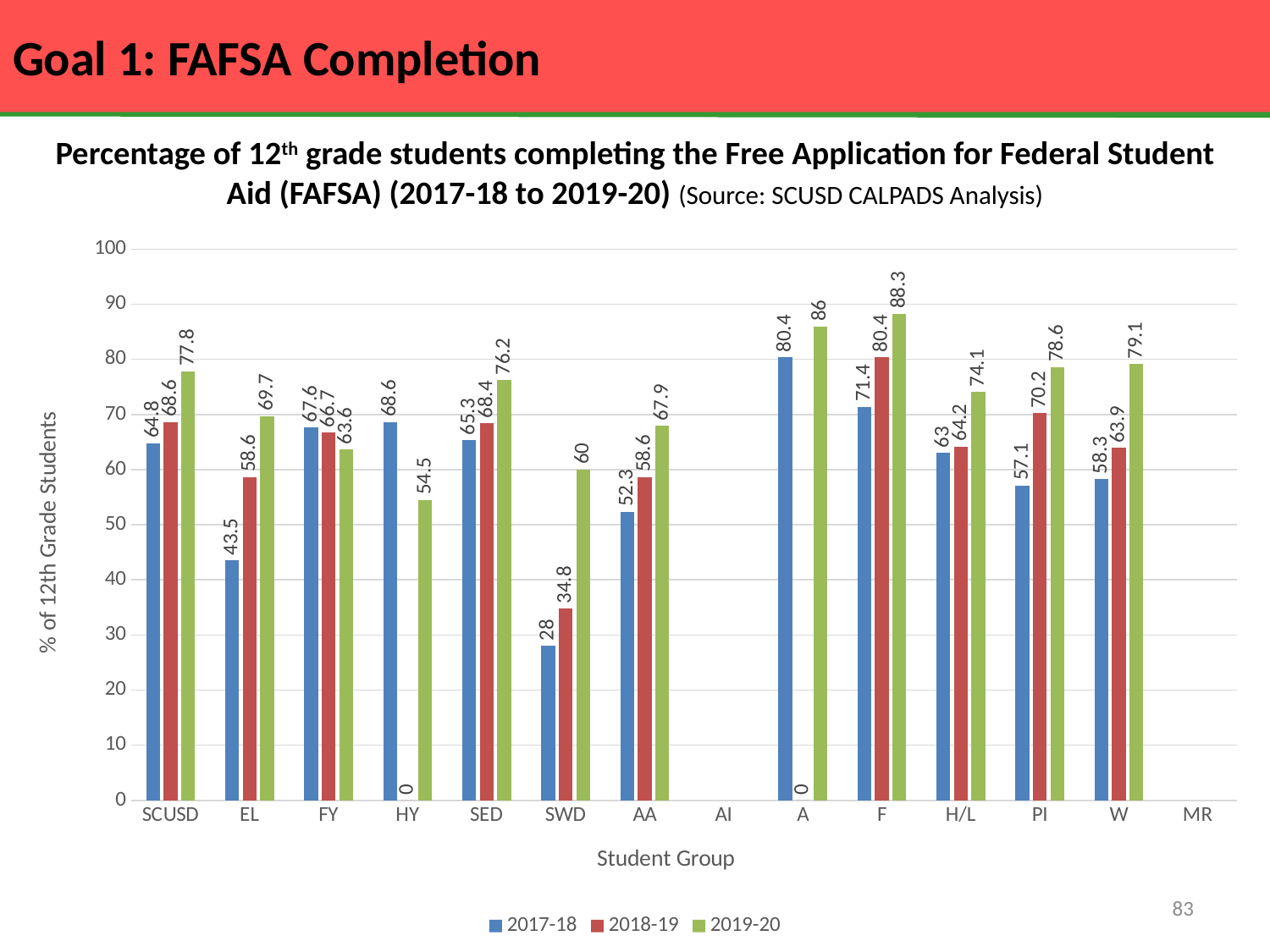
What is the difference between the 2019-20 and 2017-18 values for EL? 26.2 What is the 2018-19 value for PI? 70.2 How many series does the legend list? 3 Is the 2019-20 value for A greater or less than 80? greater What is the 2019-20 value for SCUSD? 77.8 What is the 2017-18 value for SWD? 28 Which student group has the lowest 2017-18 value? SWD Which student group has the highest 2019-20 value? F What is the label of the y axis? % of 12th Grade Students How many student groups are listed on the x axis? 14 Which is larger for FY: the 2017-18 value or the 2019-20 value? 2017-18 What kind of chart is shown on the slide? bar chart